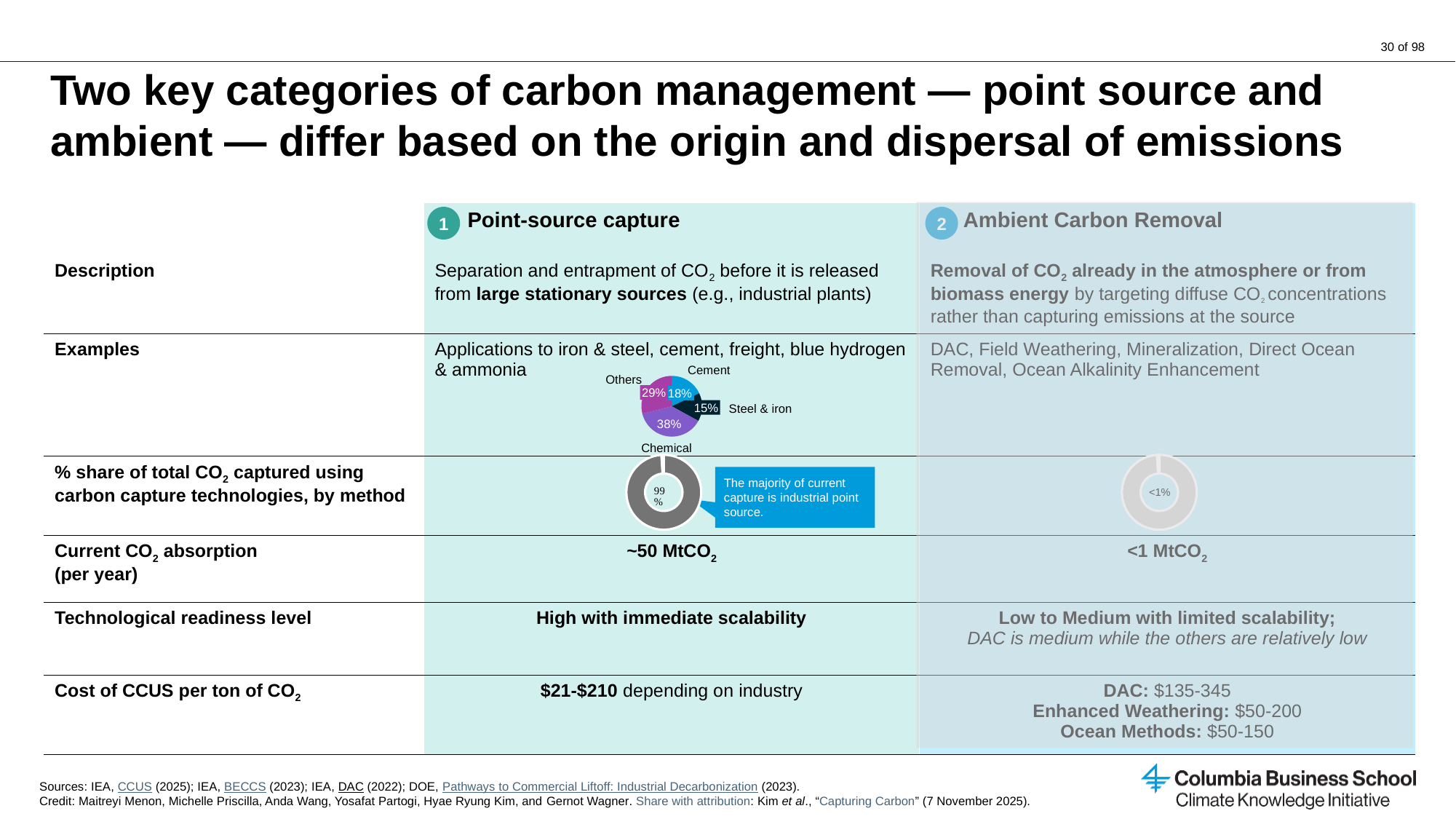
In the pie chart under Point-source capture, which is larger, Others or Cement? Others In the pie chart under Point-source capture, what share is shown for Chemical? 38% In the pie chart under Point-source capture, what share is shown for Steel & iron? 15% In the donut chart for % share of total CO2 captured, what value is shown for Point-source capture? 99% In the pie chart under Point-source capture, how many percentage points larger is Chemical than Cement? 20 percentage points In the pie chart under Point-source capture, what share is shown for Cement? 18% In the donut chart for % share of total CO2 captured, what value is shown for Ambient Carbon Removal? <1% In the pie chart under Point-source capture, which category has the smallest share? Steel & iron In the pie chart under Point-source capture, which category has the largest share? Chemical What kind of chart is used to show the breakdown of Cement, Steel & iron, Chemical and Others under Point-source capture? Pie chart How many categories does the pie chart under Point-source capture show? 4 In the pie chart under Point-source capture, what share is shown for Others? 29%